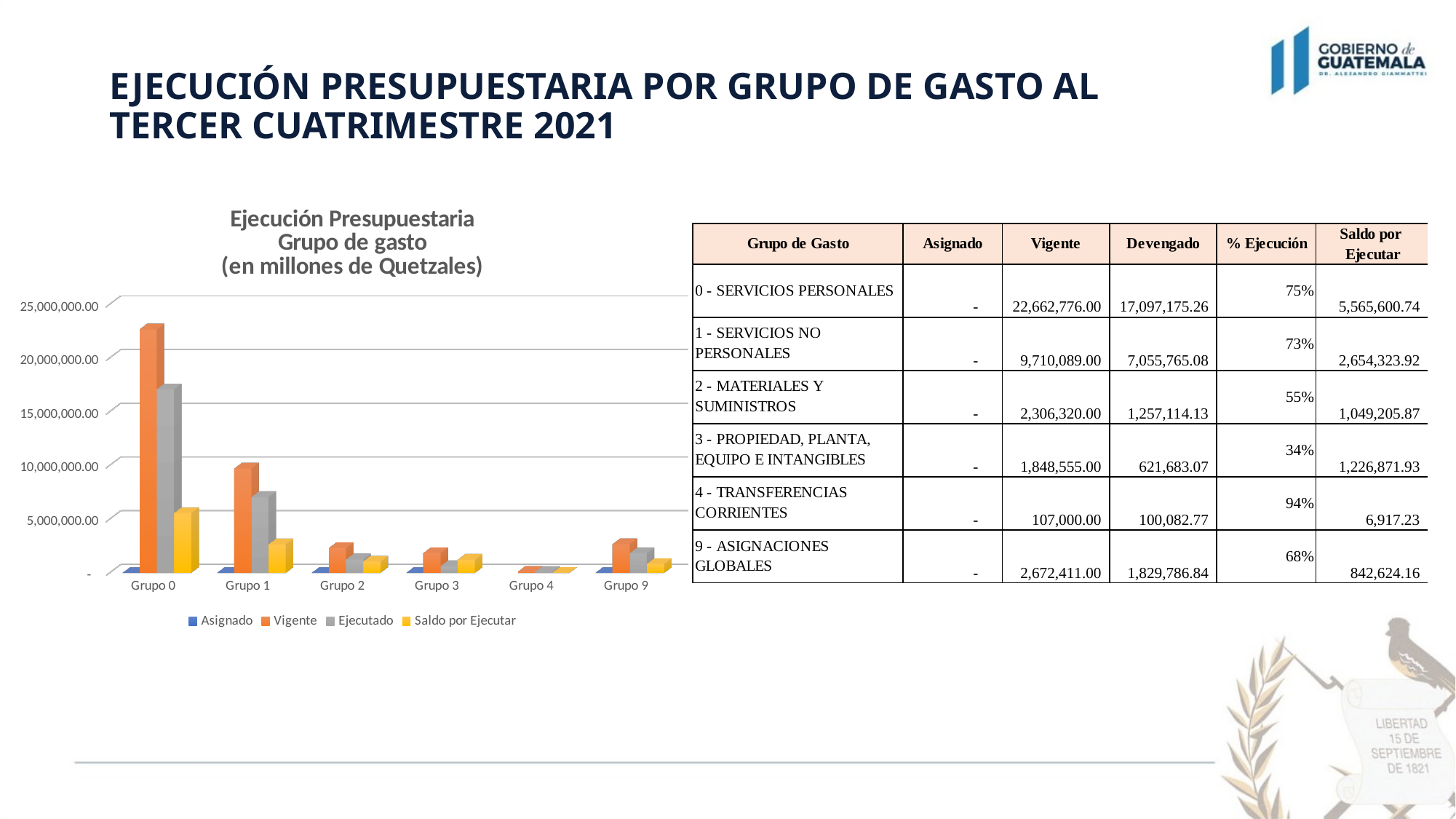
Which group has the highest Vigente bar in the chart? Grupo 0 Is the Vigente value for Grupo 0 greater or less than 20,000,000.00? greater How many series does the chart legend list? 4 Is the Ejecutado value for Grupo 0 greater or less than 15,000,000.00? greater According to the table on the slide, what is the Vigente amount for 0 - SERVICIOS PERSONALES? 22,662,776.00 What kind of chart is shown on the slide? bar chart What is the title of the chart on the slide? Ejecución Presupuestaria Grupo de gasto (en millones de Quetzales) Which is larger in the chart, the Vigente bar for Grupo 1 or for Grupo 9? Grupo 1 Which group has the lowest Vigente bar in the chart? Grupo 4 Which is larger in the chart, the Vigente bar for Grupo 3 or for Grupo 9? Grupo 9 How many groups (categories) are shown on the x axis of the chart? 6